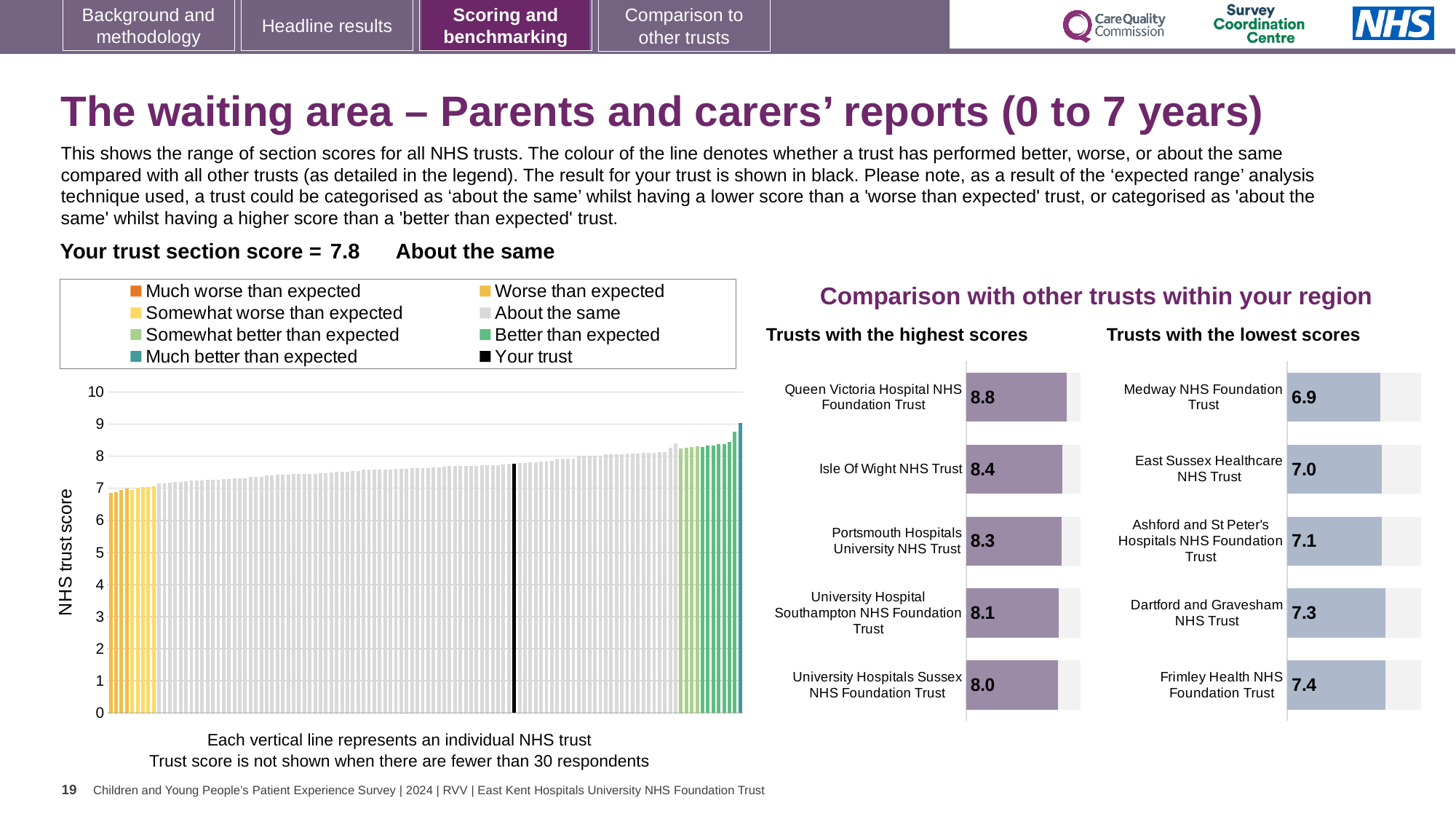
In the 'Trusts with the lowest scores' chart, which has the larger score: Dartford and Gravesham NHS Trust or Frimley Health NHS Foundation Trust? Frimley Health NHS Foundation Trust In the 'Trusts with the lowest scores' chart, which trust has the lowest score? Medway NHS Foundation Trust How many trusts are listed in the 'Trusts with the highest scores' chart? 5 What is the y-axis label of the large chart on the left? NHS trust score In the 'Trusts with the highest scores' chart, what is the difference between the scores of Queen Victoria Hospital NHS Foundation Trust and University Hospitals Sussex NHS Foundation Trust? 0.8 In the large chart on the left, what is the section score for your trust (the black bar)? 7.8 What kind of chart is the large chart on the left showing all NHS trusts? Bar chart How many entries does the legend above the large chart on the left list? 8 In the 'Trusts with the highest scores' chart, which trust has the highest score? Queen Victoria Hospital NHS Foundation Trust In the 'Trusts with the highest scores' chart, what is the score for Queen Victoria Hospital NHS Foundation Trust? 8.8 In the large chart on the left, do the trust scores rise or fall from left to right? Rise In the 'Trusts with the lowest scores' chart, what is the score for Medway NHS Foundation Trust? 6.9